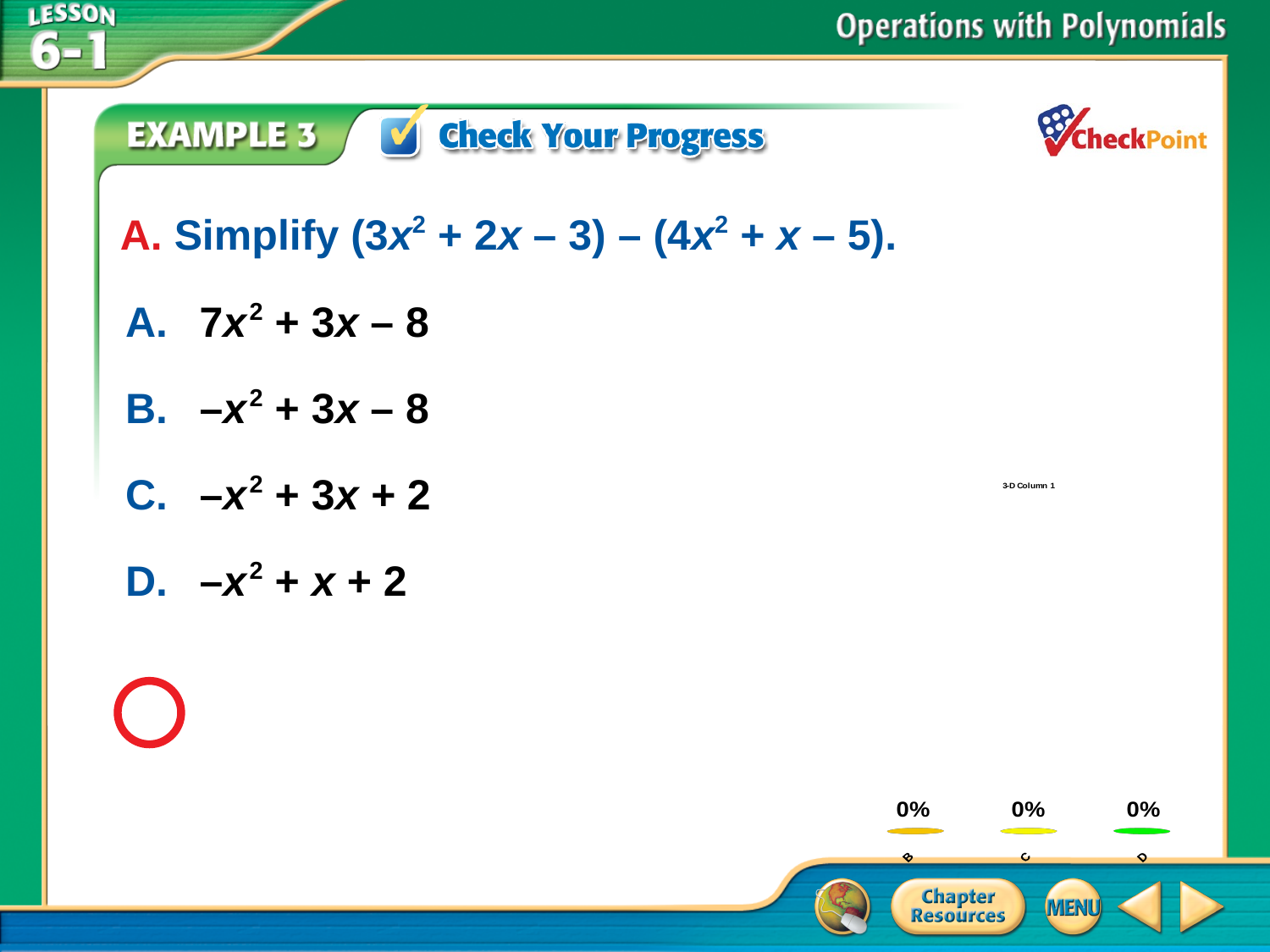
In the chart at the bottom right, what is the value shown for category D? 0% In the chart at the bottom right, is the value for B greater or less than 50%? less In the chart at the bottom right, what is the difference between the values for C and D? 0% In the chart at the bottom right, what is the value shown for category C? 0% In the chart at the bottom right, what is the value shown for category B? 0% What kind of chart is shown at the bottom right of the slide? bar chart